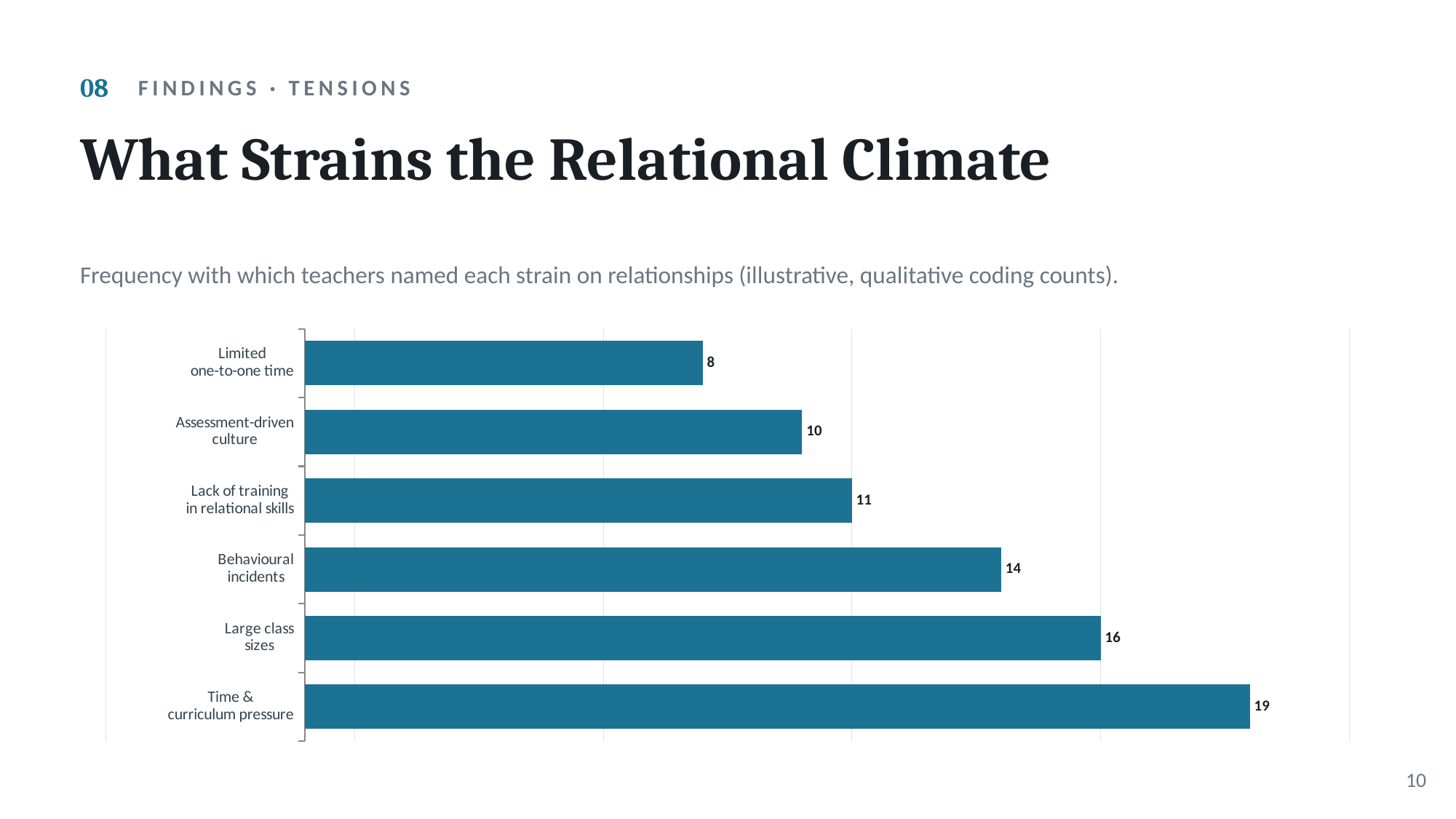
What is the value for Assessment-driven culture? 10 Which strain was named least frequently? Limited one-to-one time What is the value for Behavioural incidents? 14 Which has a higher value, Large class sizes or Behavioural incidents? Large class sizes What is the value for Lack of training in relational skills? 11 What is the value for Large class sizes? 16 Which strain was named most frequently? Time & curriculum pressure What is the difference between the values for Time & curriculum pressure and Limited one-to-one time? 11 How many strain categories are shown in the chart? 6 What is the value for Limited one-to-one time? 8 What is the value for Time & curriculum pressure? 19 What kind of chart is shown on the slide? Bar chart